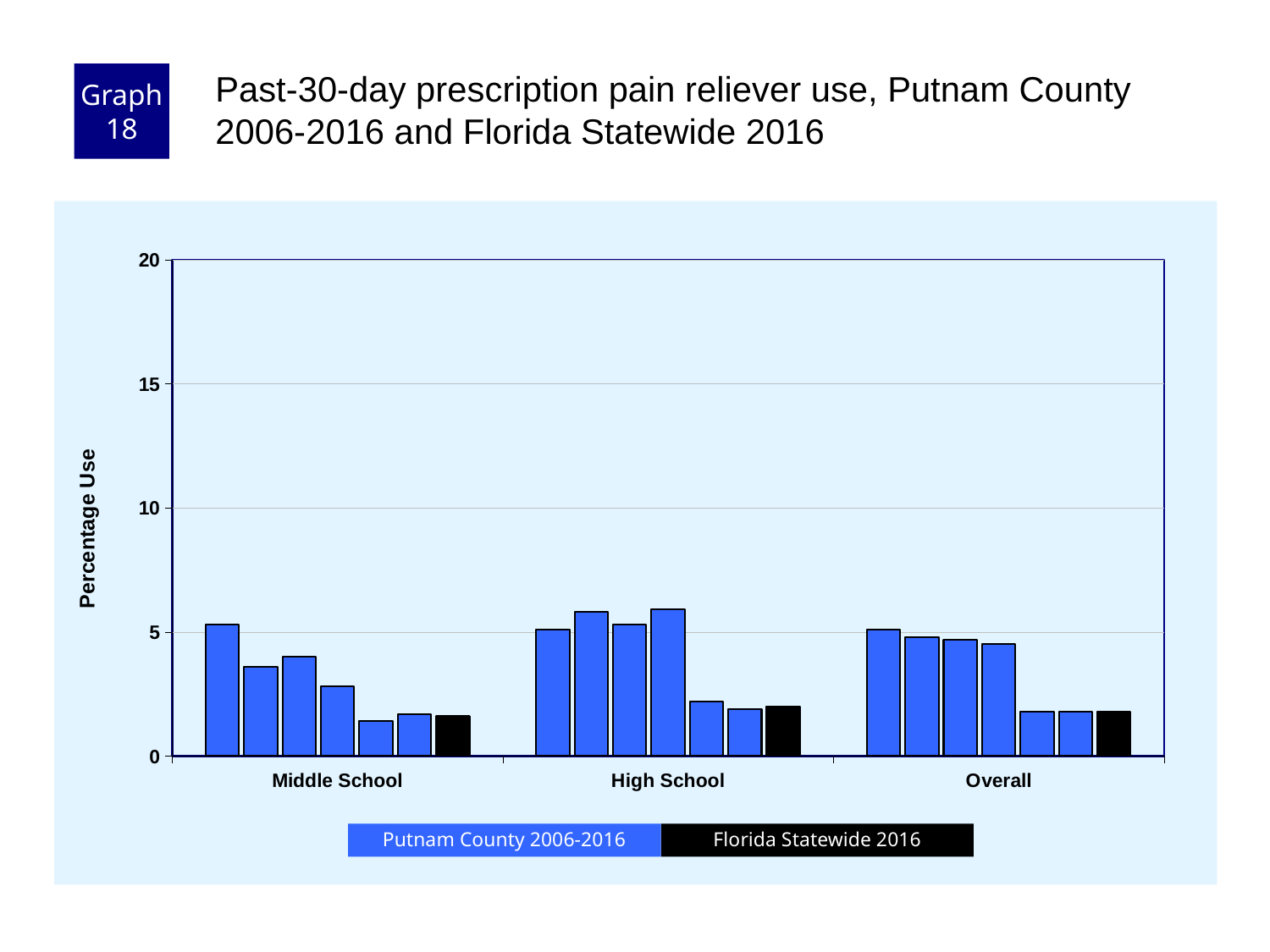
Do the Putnam County bars in the Overall category rise or fall from left to right? fall Which colour represents Florida Statewide 2016 in the legend? black Is the value for Florida Statewide 2016 in the High School category greater or less than 5? less Is the first Putnam County bar in the Overall category larger or smaller than the Florida Statewide 2016 bar in the Overall category? larger Is the tallest Putnam County bar in the High School category greater or less than 10? less Is the first Putnam County bar in the Middle School category greater or less than 5? greater Which category contains the tallest bar on the chart? High School How many school-level categories are shown on the x axis? 3 What kind of chart is shown on the slide? bar chart What is the label of the y axis? Percentage Use How many series does the legend list? 2